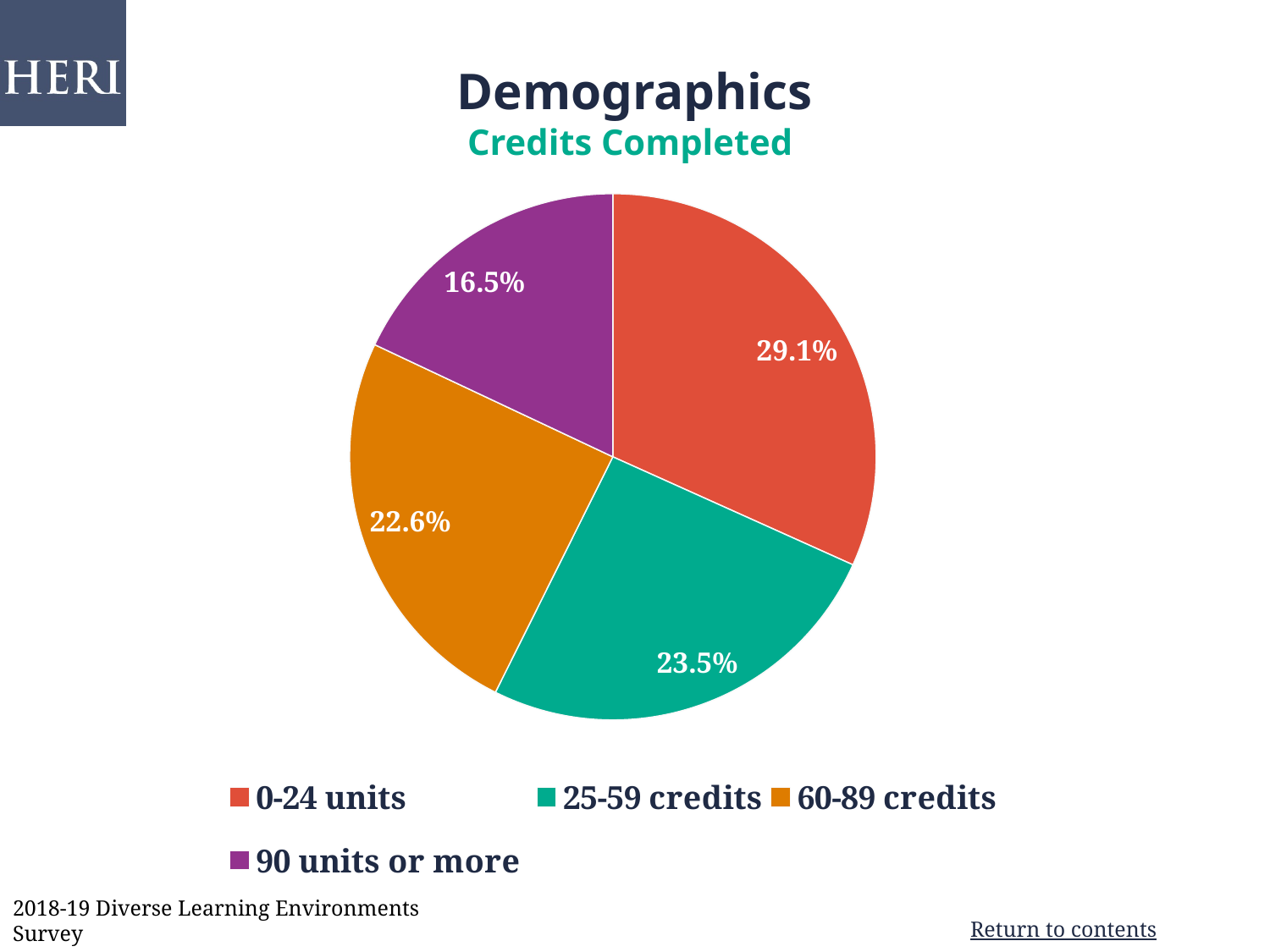
Which category has the largest slice of the pie? 0-24 units What percentage of the pie is for 0-24 units? 29.1% What kind of chart is shown on the slide? Pie chart What is the difference in percentage points between the 0-24 units slice and the 90 units or more slice? 12.6 What percentage of the pie is for 90 units or more? 16.5% What percentage of the pie is for 60-89 credits? 22.6% What is the subtitle of the chart shown under 'Demographics'? Credits Completed What colour is the slice for 60-89 credits? Orange Which is larger, the slice for 25-59 credits or the slice for 60-89 credits? 25-59 credits Which category has the smallest slice of the pie? 90 units or more How many categories does the pie chart show? 4 What percentage of the pie is for 25-59 credits? 23.5%